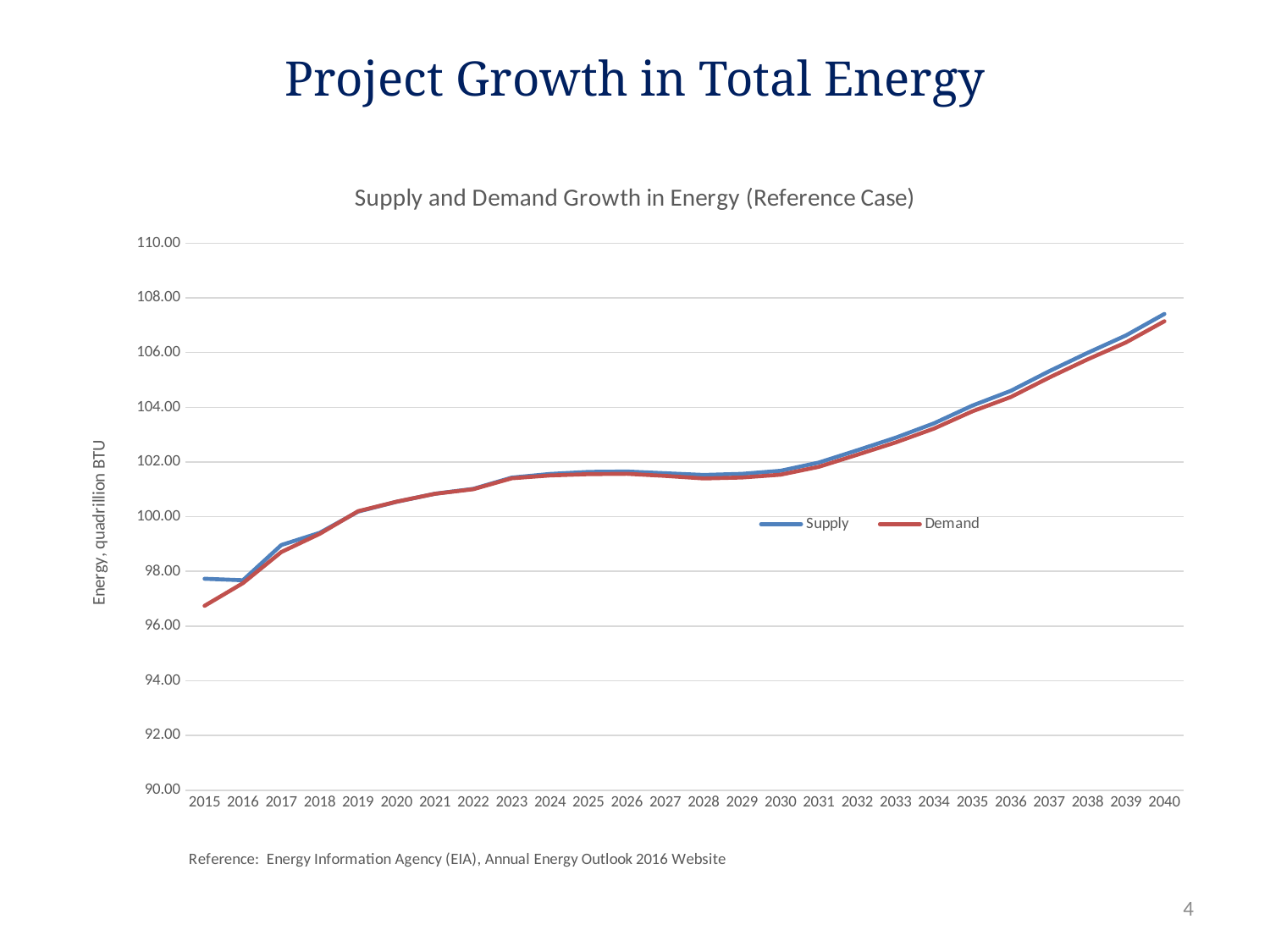
Is the Demand value for 2015 greater or less than 98.00? less Is the Supply value for 2037 greater or less than 104.00? greater What kind of chart is shown on the slide? line chart What is the label on the vertical axis? Energy, quadrillion BTU How many years are plotted along the x axis? 26 In which year is the Demand value lowest? 2015 Is the Supply value for 2040 greater or less than 106.00? greater How many series does the legend list? 2 What is the title of the chart? Supply and Demand Growth in Energy (Reference Case) Do the Supply values generally rise or fall from 2015 to 2040? rise In 2015, which is larger, Supply or Demand? Supply In which year is the Supply value highest? 2040